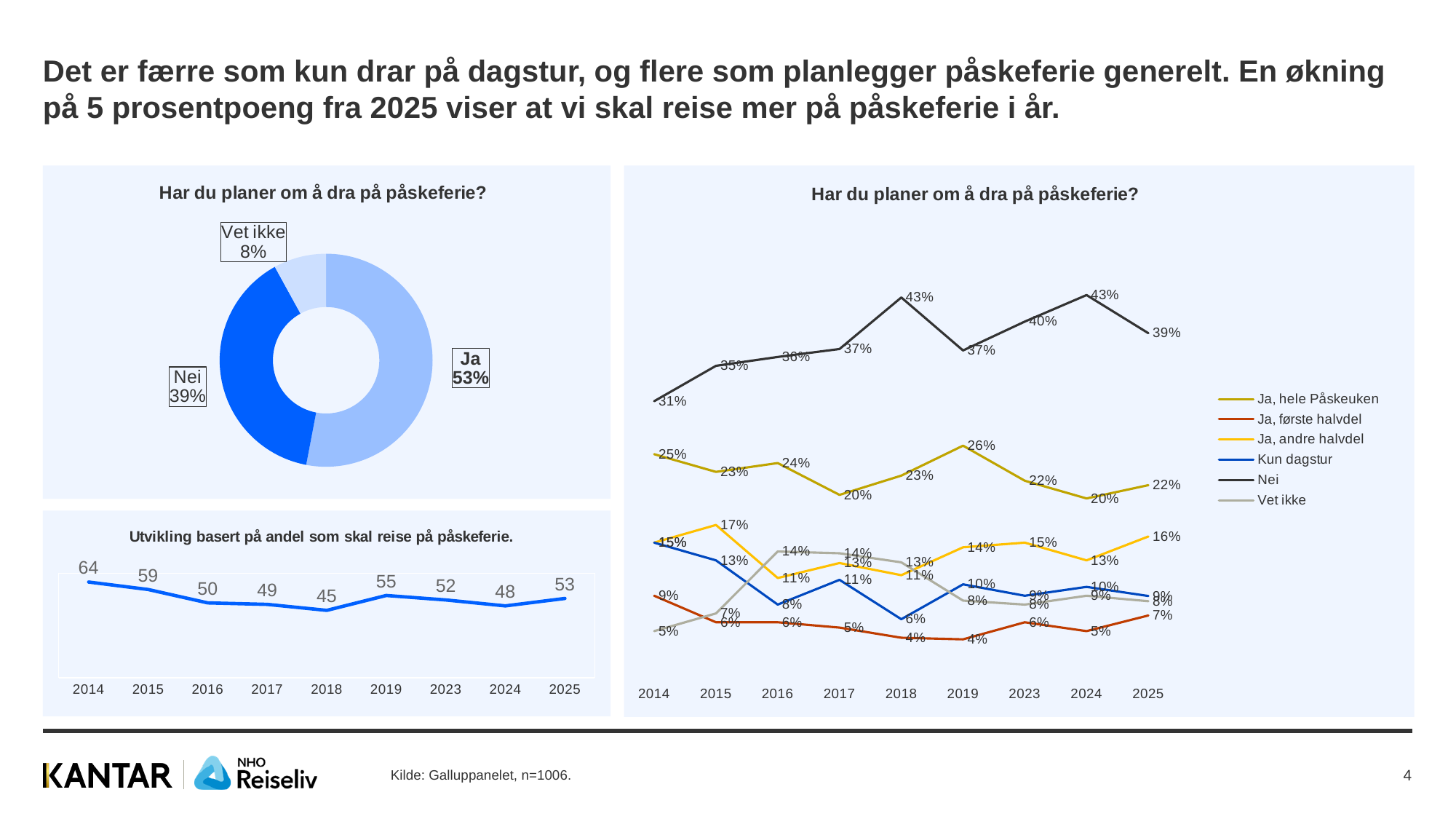
In the chart "Utvikling basert på andel som skal reise på påskeferie.", which year has the highest value? 2014 In the line chart on the right, what is the value for "Nei" in 2018? 43% In the donut chart on the left, what share answered "Vet ikke"? 8% In the chart "Utvikling basert på andel som skal reise på påskeferie.", what is the difference between the 2025 and 2024 values? 5 In the donut chart on the left, what share answered "Ja"? 53% In the donut chart on the left, which answer has the smallest share? Vet ikke In the chart "Utvikling basert på andel som skal reise på påskeferie.", what is the value for 2018? 45 In the line chart on the right, which is larger in 2025: "Ja, andre halvdel" or "Ja, første halvdel"? Ja, andre halvdel In the chart "Utvikling basert på andel som skal reise på påskeferie.", how many years are plotted? 9 In the donut chart on the left, what is the difference between the "Ja" and "Nei" shares? 14 percentage points In the line chart on the right, what is the value for "Ja, hele Påskeuken" in 2019? 26% In the line chart on the right, how many series does the legend list? 6